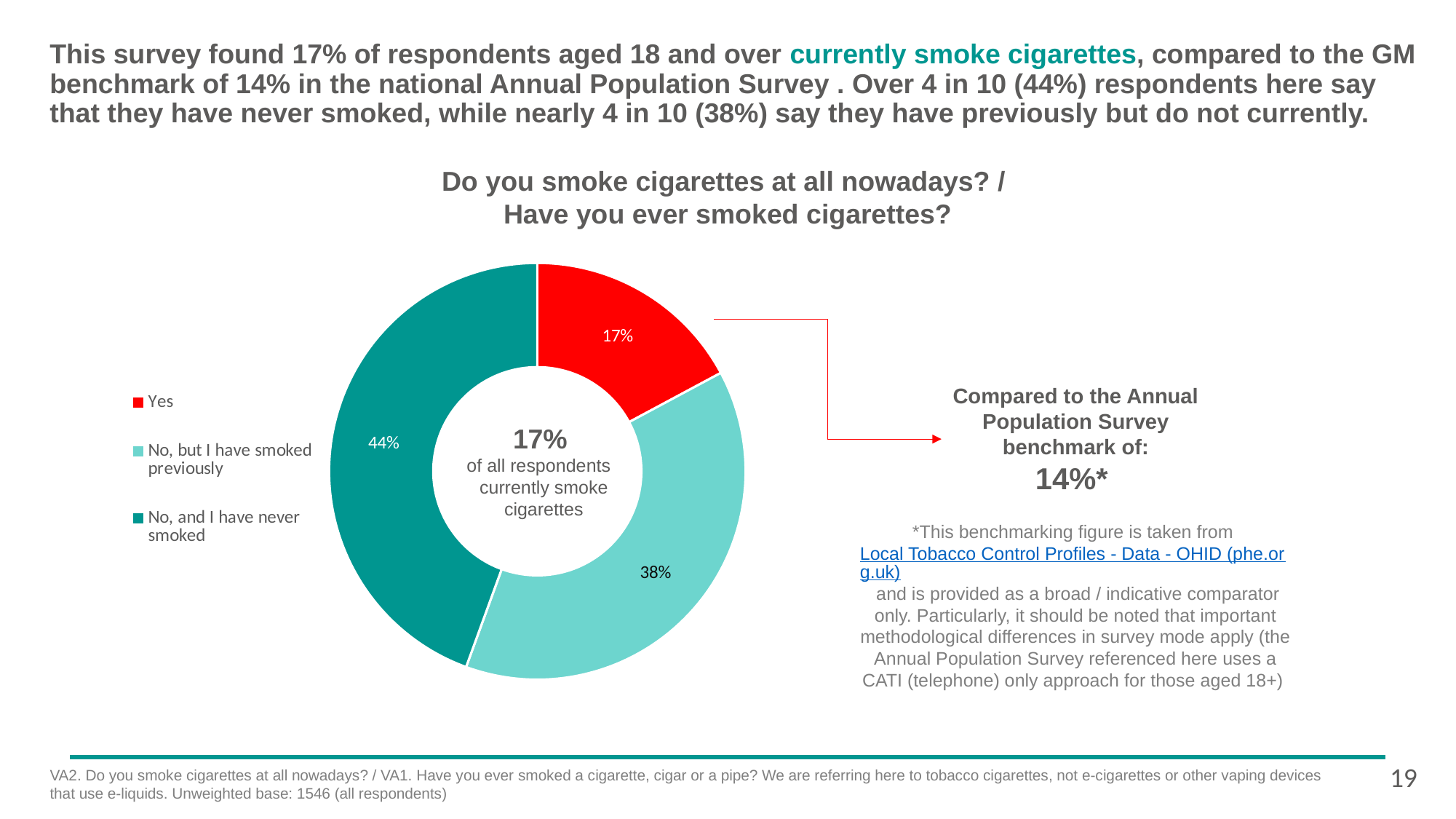
What is the difference in percentage points between "No, and I have never smoked" and "No, but I have smoked previously"? 6 Which response category has the largest share of the pie? No, and I have never smoked What colour is the "Yes" slice in the chart? Red What percentage of respondents answered "Yes" to currently smoking cigarettes? 17% What type of chart is shown on the slide? Pie chart (doughnut) Which is larger: the share for "Yes" or the share for "No, but I have smoked previously"? No, but I have smoked previously What is the Annual Population Survey benchmark figure shown next to the chart? 14%* What is the difference in percentage points between "No, but I have smoked previously" and "Yes"? 21 What percentage of respondents said "No, but I have smoked previously"? 38% What percentage of respondents said "No, and I have never smoked"? 44% How many categories does the pie chart show? 3 Which response category has the smallest share of the pie? Yes